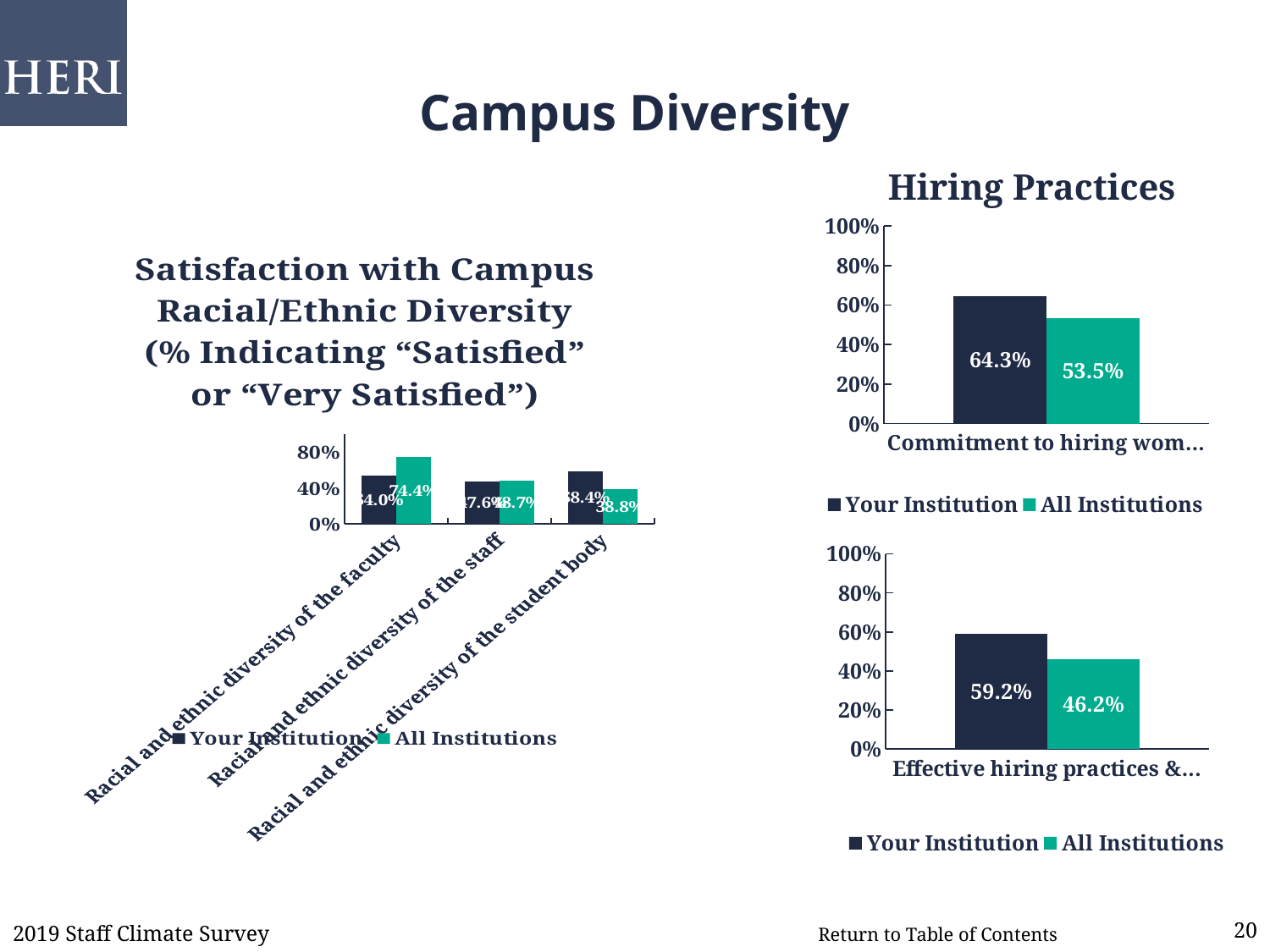
In the left chart, Satisfaction with Campus Racial/Ethnic Diversity, what is the All Institutions value for racial and ethnic diversity of the faculty? 74.4% In the top-right Hiring Practices chart, what is the value for Your Institution for "Commitment to hiring wom..."? 64.3% What kind of chart is the left chart, Satisfaction with Campus Racial/Ethnic Diversity? bar chart How many categories are shown on the x axis of the left chart, Satisfaction with Campus Racial/Ethnic Diversity? 3 In the bottom-right chart ("Effective hiring practices &..."), what is the value for Your Institution? 59.2% In the bottom-right chart ("Effective hiring practices &..."), what is the value for All Institutions? 46.2% In the bottom-right chart ("Effective hiring practices &..."), which series has the larger value, Your Institution or All Institutions? Your Institution In the top-right Hiring Practices chart, is the value for All Institutions greater or less than 60%? less In the bottom-right chart ("Effective hiring practices &..."), what is the difference between Your Institution and All Institutions? 13.0% In the top-right Hiring Practices chart, what is the difference between Your Institution and All Institutions? 10.8% How many series does the legend of the top-right Hiring Practices chart list? 2 In the top-right Hiring Practices chart, what is the value for All Institutions? 53.5%